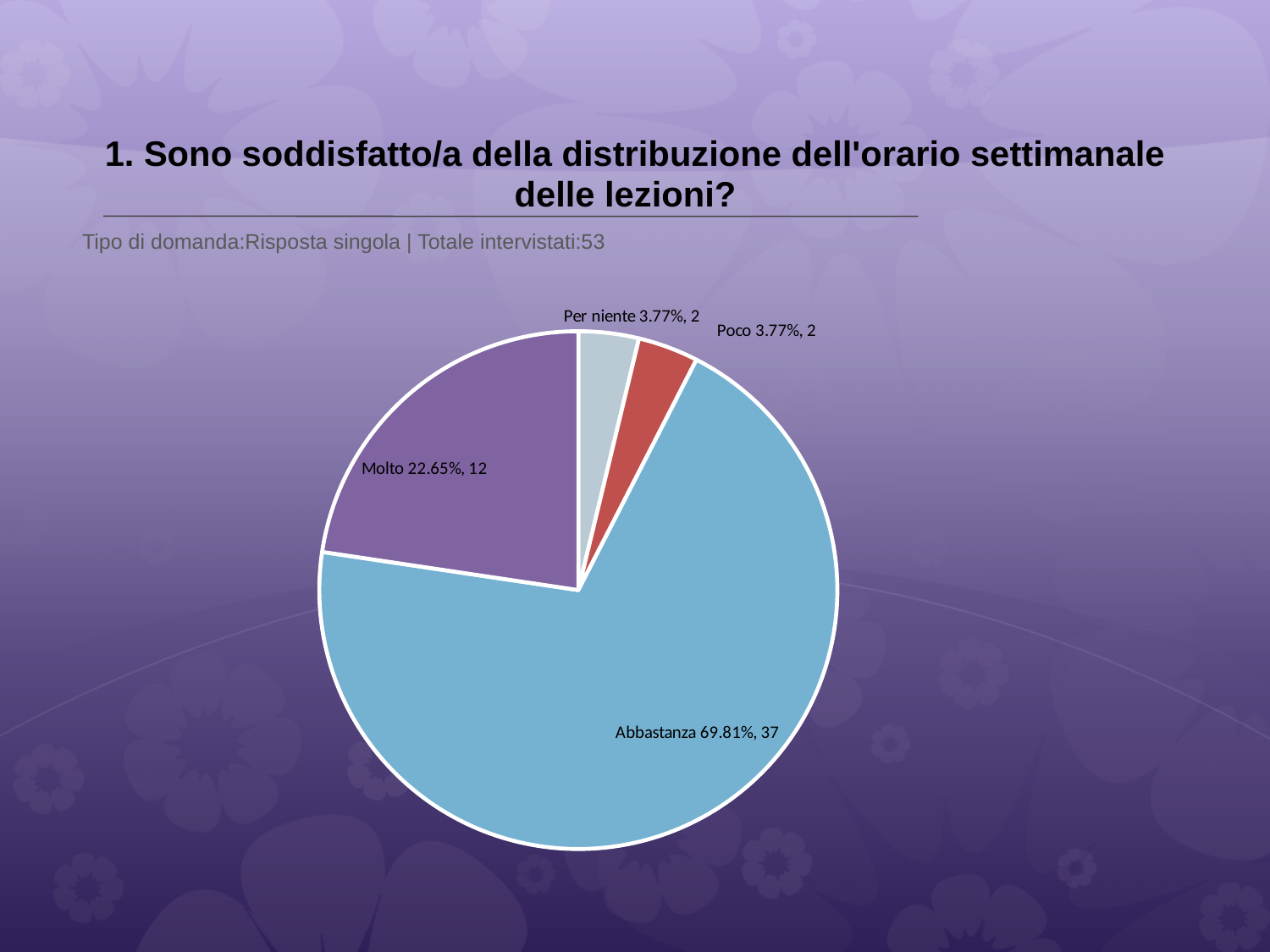
How many more respondents answered "Abbastanza" than "Molto"? 25 Which response category has the largest slice of the pie? Abbastanza What share of the pie does the "Abbastanza" slice represent? 69.81% What kind of chart is shown on the slide? pie chart How many slices does the pie chart have? 4 How many respondents answered "Molto"? 12 According to the subtitle, what is the total number of respondents (Totale intervistati)? 53 How many respondents answered "Per niente"? 2 Which has more respondents, "Molto" or "Poco"? Molto How many respondents answered "Abbastanza"? 37 What percentage of the pie is the "Molto" slice? 22.65% What share of the pie does the "Poco" slice represent? 3.77%